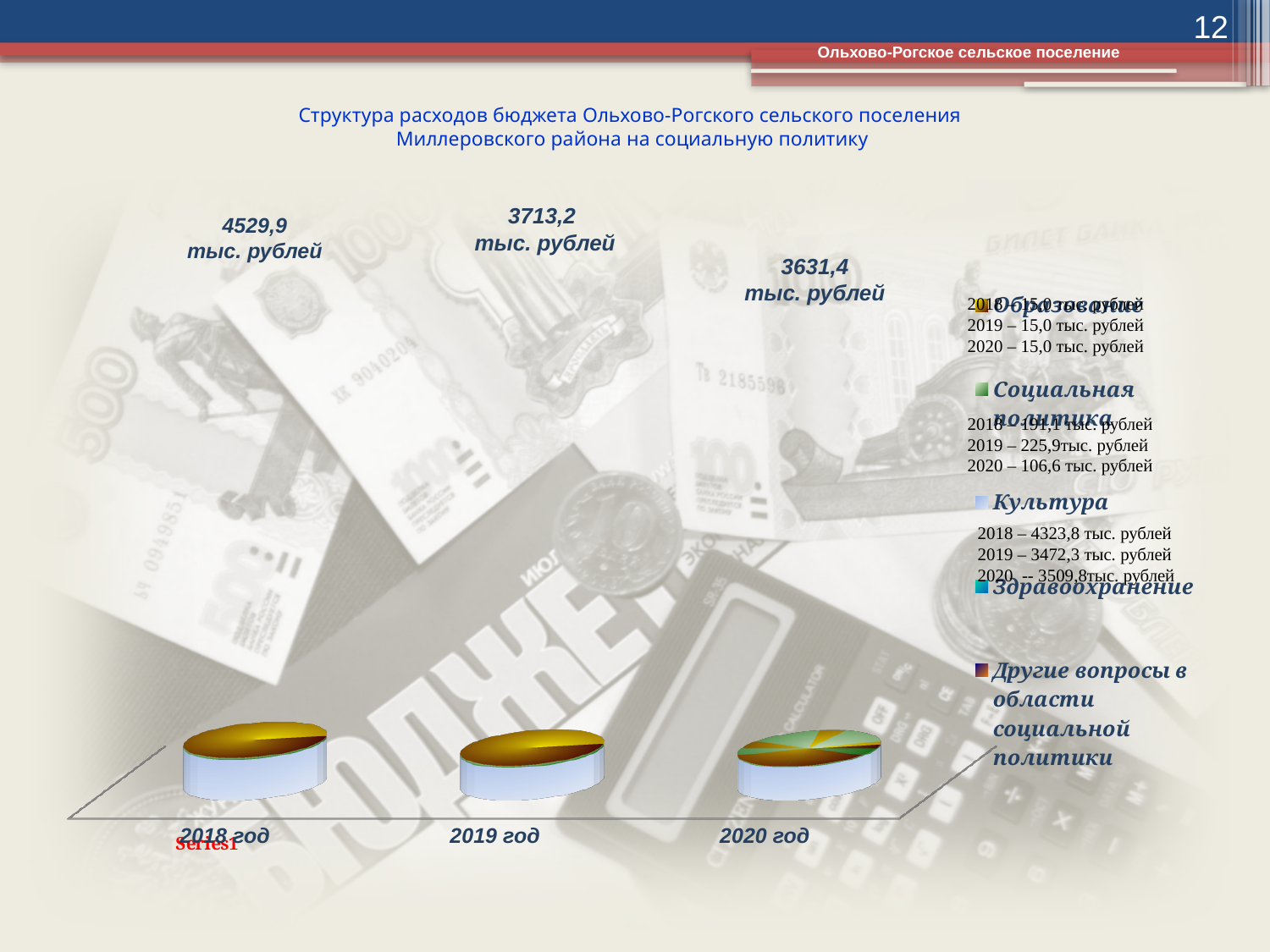
What total is printed above the 2019 год pie chart? 3713,2 тыс. рублей According to the text next to the legend, what was the value for Социальная политика in 2019? 225,9 тыс. рублей According to the text next to the legend, what was the value for Культура in 2020? 3509,8 тыс. рублей How many categories does the legend list? 5 What total is printed above the 2020 год pie chart? 3631,4 тыс. рублей What total is printed above the 2018 год pie chart? 4529,9 тыс. рублей Do the totals printed above the pie charts rise or fall from 2018 год to 2020 год? Fall Which year's pie chart has the smallest total printed above it? 2020 год Is the total printed above the 2018 год pie chart larger or smaller than the total above the 2019 год pie chart? Larger What kind of charts are shown on the slide? 3D stacked bar chart (cylinder-shaped bars) Which year's pie chart has the largest total printed above it? 2018 год